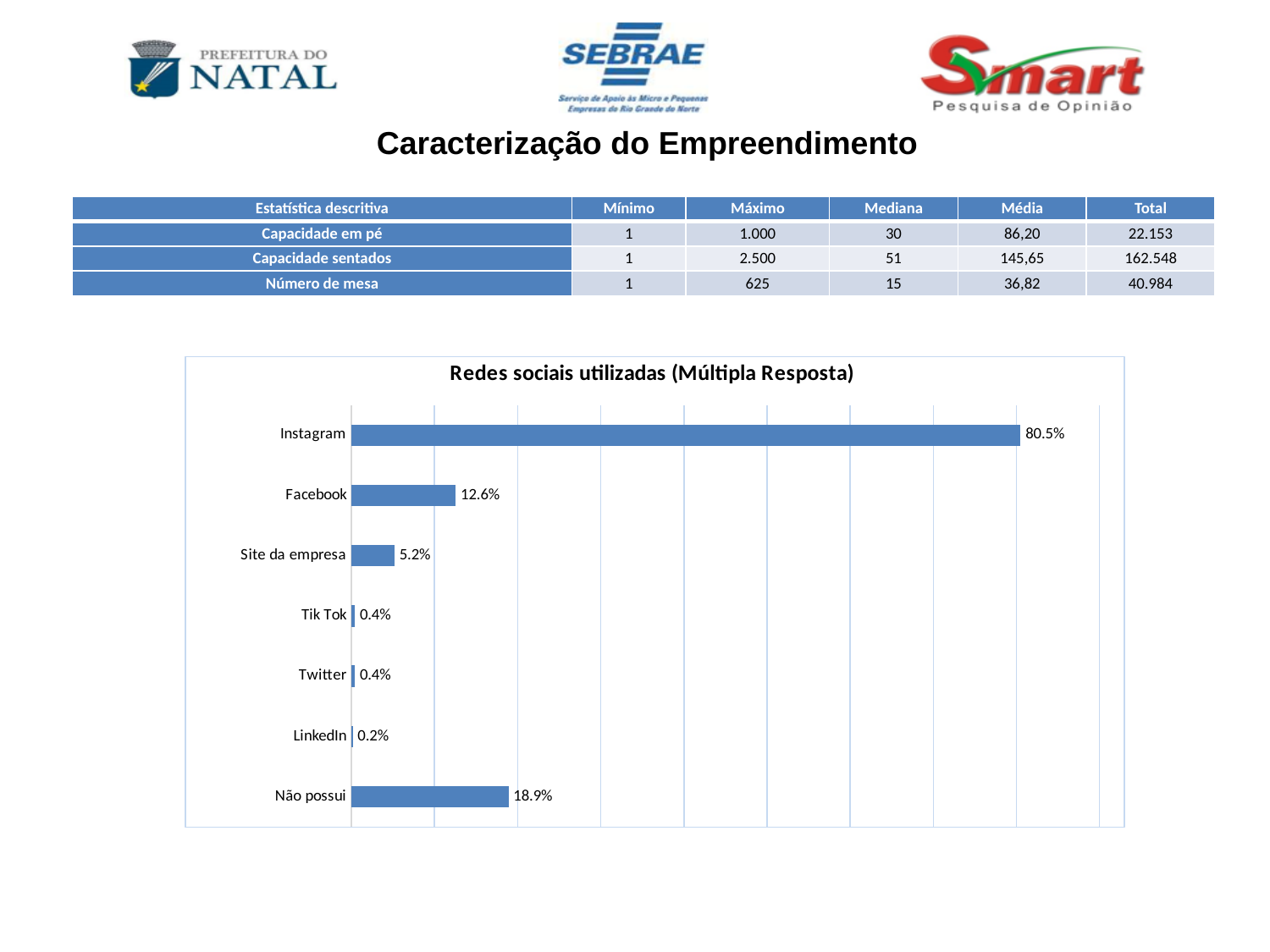
What is the title of the chart? Redes sociais utilizadas (Múltipla Resposta) Which category has the lowest value in the chart? LinkedIn What is the value for Não possui in the chart? 18.9% Which is larger, the value for Facebook or the value for Não possui? Não possui How many categories are shown in the chart? 7 What is the value for Site da empresa in the chart? 5.2% What is the value for Instagram in the chart? 80.5% What is the difference between the values for Instagram and Facebook? 67.9% What is the value for LinkedIn in the chart? 0.2% What kind of chart is shown on the slide? Bar chart Which category has the highest value in the chart? Instagram What is the value for Facebook in the chart? 12.6%